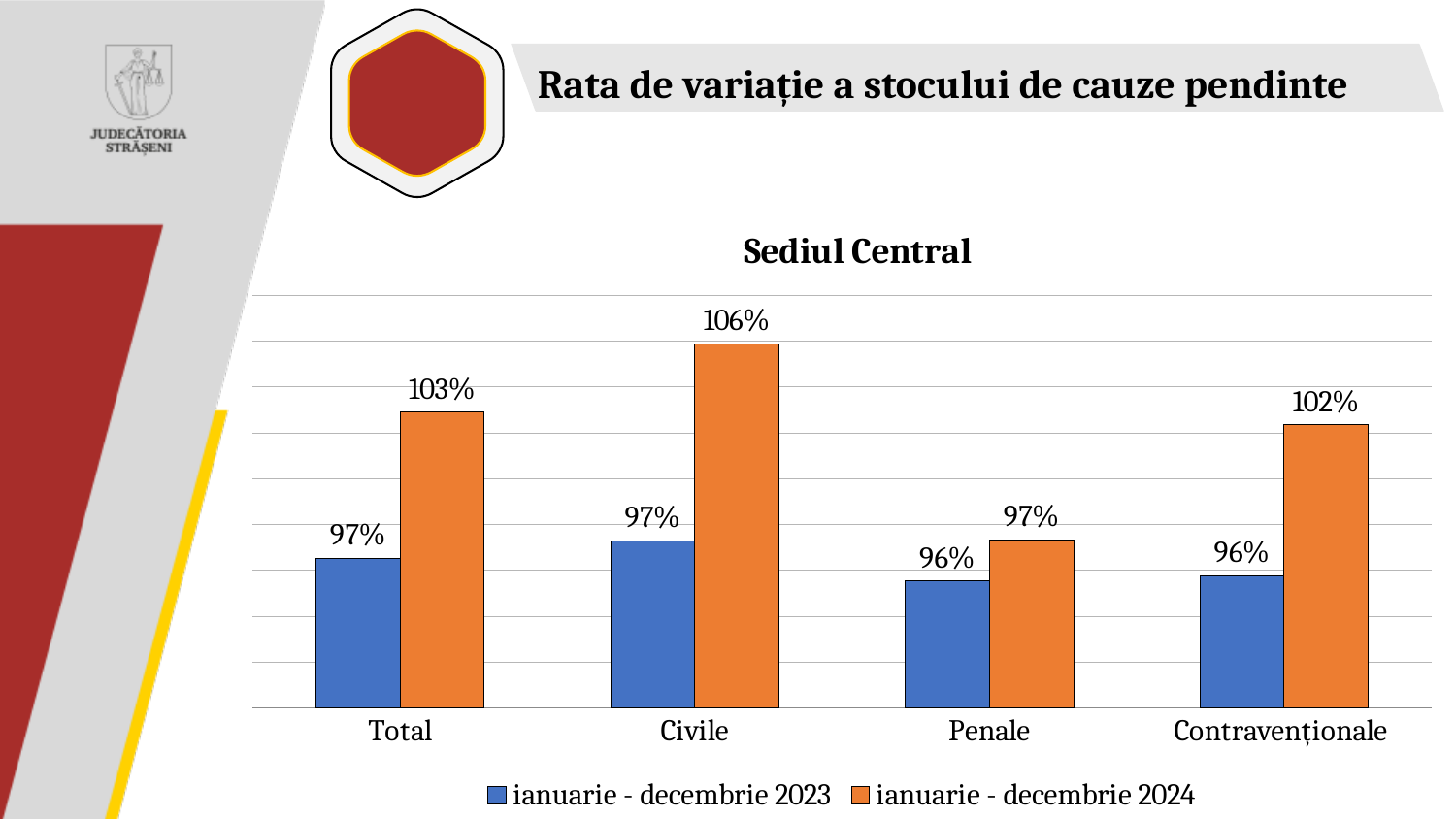
What is the title of the chart? Sediul Central Which category has the lowest value in ianuarie - decembrie 2024? Penale What kind of chart is shown on the slide? Bar chart What is the difference between the ianuarie - decembrie 2024 and ianuarie - decembrie 2023 values for Civile? 9% What is the value for Contravenționale in ianuarie - decembrie 2024? 102% What is the value for Total in ianuarie - decembrie 2023? 97% What is the value for Civile in ianuarie - decembrie 2024? 106% Which category has the highest value in ianuarie - decembrie 2024? Civile What is the value for Penale in ianuarie - decembrie 2023? 96% How many categories are shown on the x axis? 4 Which is larger: the ianuarie - decembrie 2024 value for Total or for Contravenționale? Total How many series does the legend list? 2